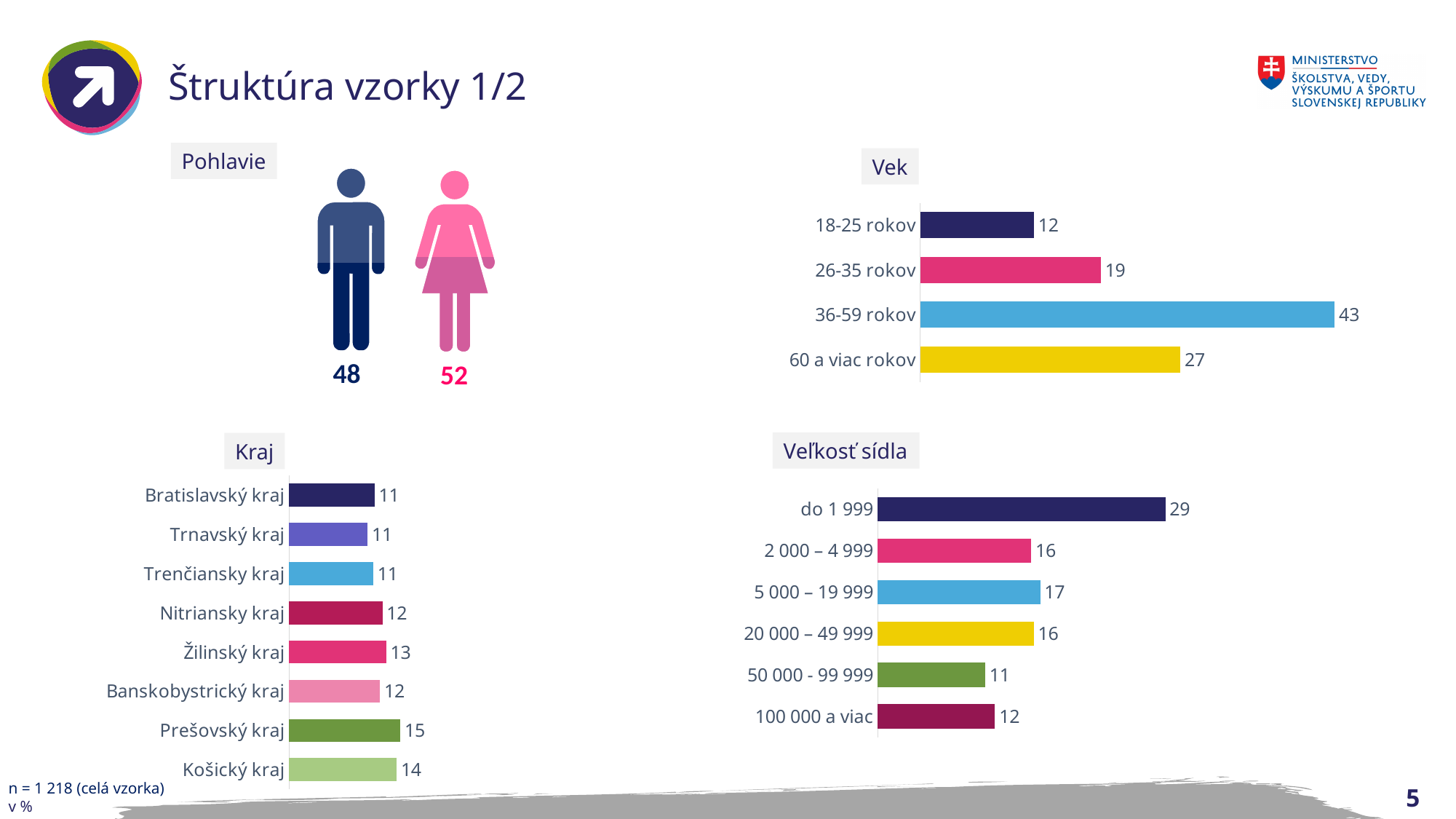
In the "Kraj" chart, which region has the highest value? Prešovský kraj What type of chart is the "Kraj" chart? Bar chart How many regions are shown in the "Kraj" chart? 8 In the "Veľkosť sídla" chart, what is the difference between the values for do 1 999 and 100 000 a viac? 17 In the "Vek" chart, what is the value for 36-59 rokov? 43 In the "Vek" chart, what is the difference between the values for 36-59 rokov and 60 a viac rokov? 16 In the "Veľkosť sídla" chart, what is the value for do 1 999? 29 In the "Vek" chart, which age group has the lowest value? 18-25 rokov In the "Veľkosť sídla" chart, which category has the lowest value? 50 000 - 99 999 In the "Kraj" chart, which is larger: the value for Žilinský kraj or Košický kraj? Košický kraj In the "Kraj" chart, what is the value for Prešovský kraj? 15 How many categories does the "Vek" chart show? 4